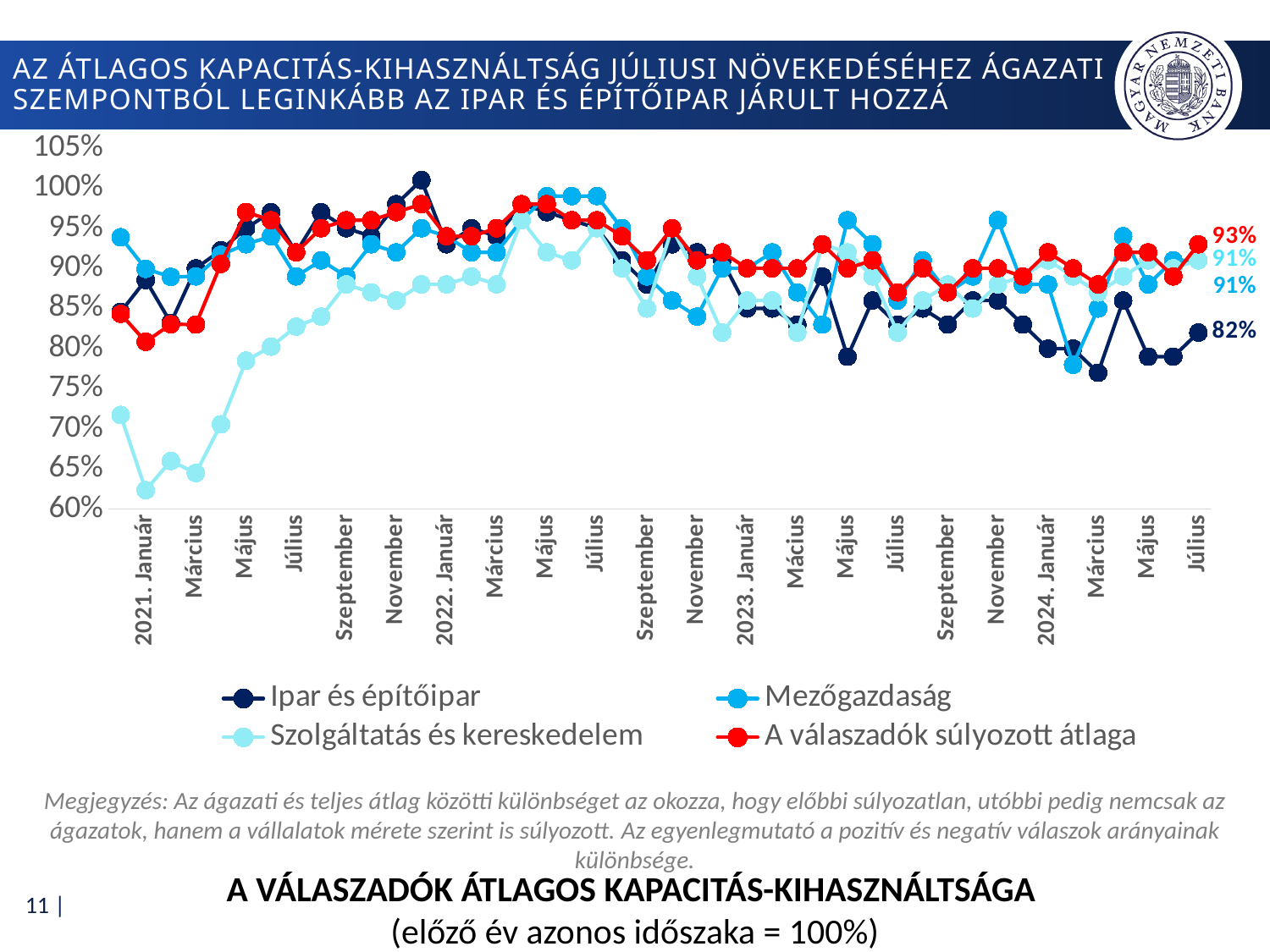
How many series does the legend list? 4 Does the 'Szolgáltatás és kereskedelem' series rise or fall from 2021. Január to 2022 Május? Rise Which series has the lowest value at 2024 Július? Ipar és építőipar What is the value of 'Mezőgazdaság' at the last point (2024 Július)? 91% What is the value of 'Ipar és építőipar' at the last point (2024 Július)? 82% What kind of chart is shown on the slide? Line chart At 2024 Július, which is larger: 'Ipar és építőipar' or 'A válaszadók súlyozott átlaga'? A válaszadók súlyozott átlaga Which series is drawn in red? A válaszadók súlyozott átlaga What is the difference between 'A válaszadók súlyozott átlaga' and 'Ipar és építőipar' at 2024 Július? 11 percentage points Is the value for 'Szolgáltatás és kereskedelem' in 2021. Január greater or less than 75%? less What is the value of 'A válaszadók súlyozott átlaga' at the last point (2024 Július)? 93%